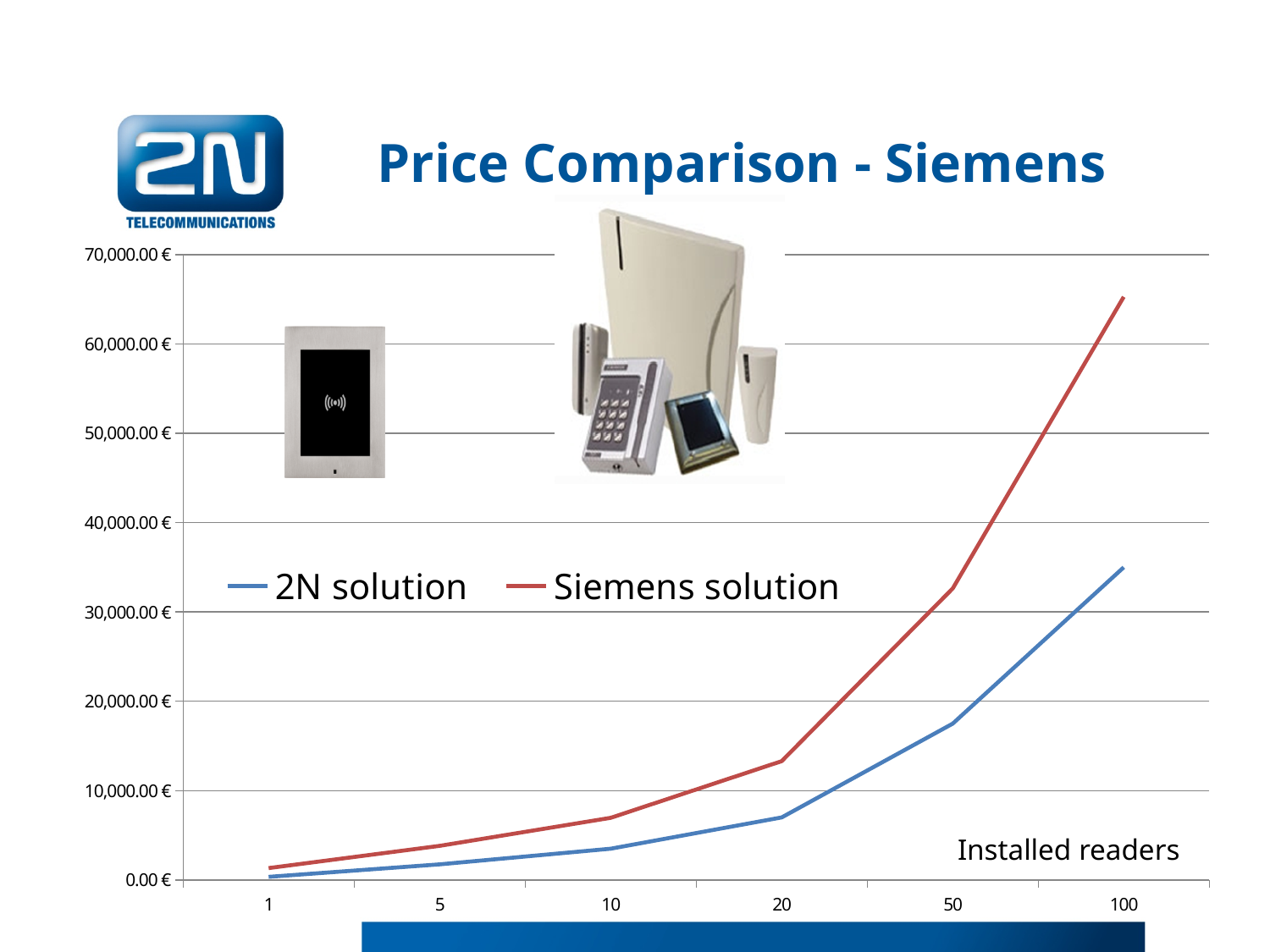
How many series does the legend list? 2 How many points are plotted along the x axis for each series? 6 What kind of chart is shown on the slide? line chart Is the value for the Siemens solution at 100 installed readers greater or less than 60,000.00 €? greater Do the values for the 2N solution rise or fall as the number of installed readers increases? rise Is the value for the Siemens solution at 20 installed readers greater or less than 10,000.00 €? greater Is the value for the 2N solution at 20 installed readers greater or less than 10,000.00 €? less What is the title of the chart? Price Comparison - Siemens Which series has the higher value at 100 installed readers, 2N solution or Siemens solution? Siemens solution What colour is the line for the Siemens solution? red